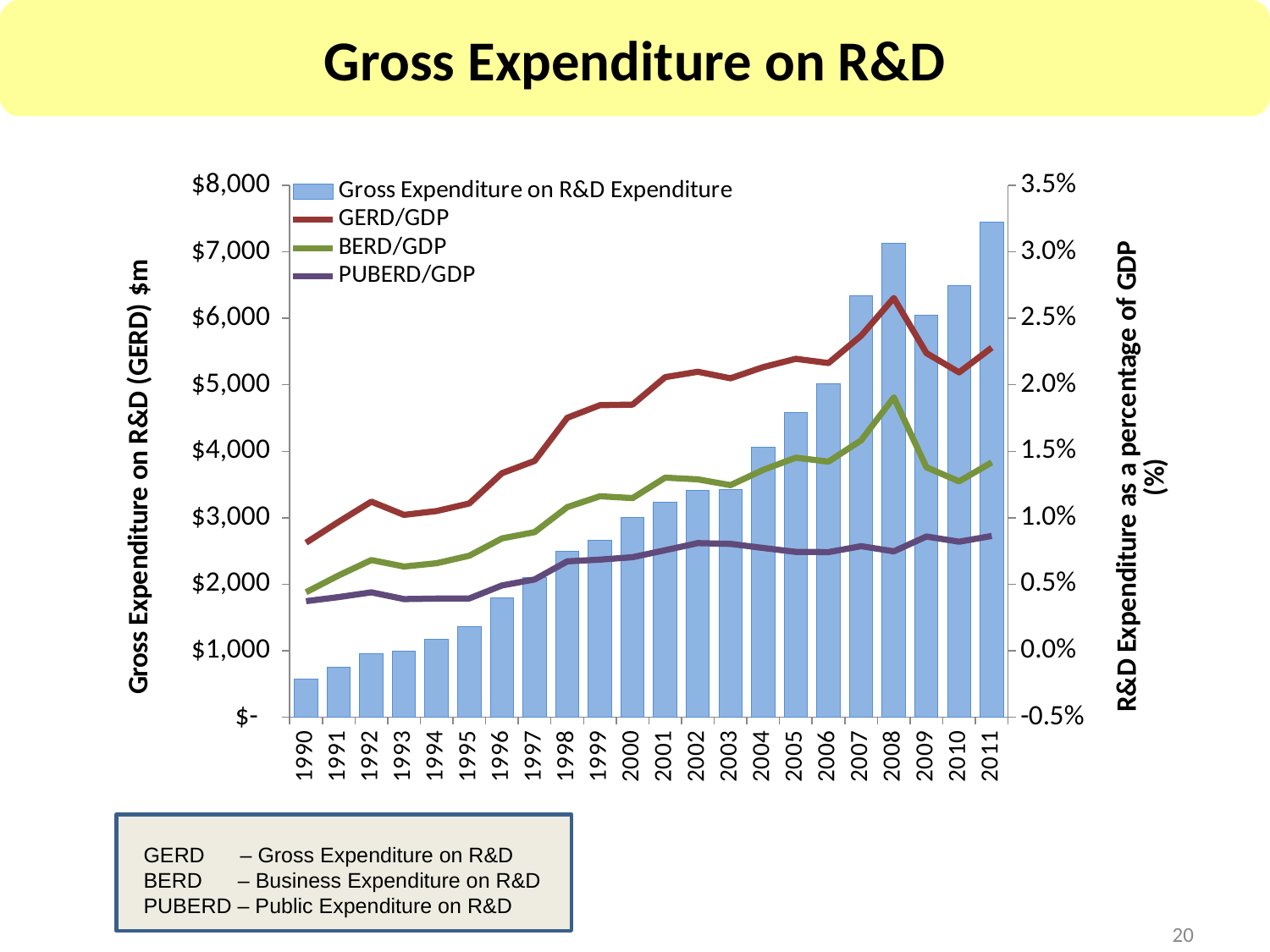
Is the Gross Expenditure on R&D bar for 1990 greater or less than $1,000? less How many years are shown on the x axis? 22 Overall, do the Gross Expenditure on R&D bars rise or fall from 1990 to 2011? rise Which is larger, the Gross Expenditure on R&D bar for 2011 or for 2009? 2011 Is the GERD/GDP value for 2008 greater or less than 2.5%? greater Is the BERD/GDP value for 2008 greater or less than 1.5%? greater What kind of chart is shown on the slide? A combination bar and line chart Which year has the lowest Gross Expenditure on R&D bar? 1990 How many series does the legend list? 4 Which year has the highest Gross Expenditure on R&D bar? 2011 In which year does the GERD/GDP line reach its peak? 2008